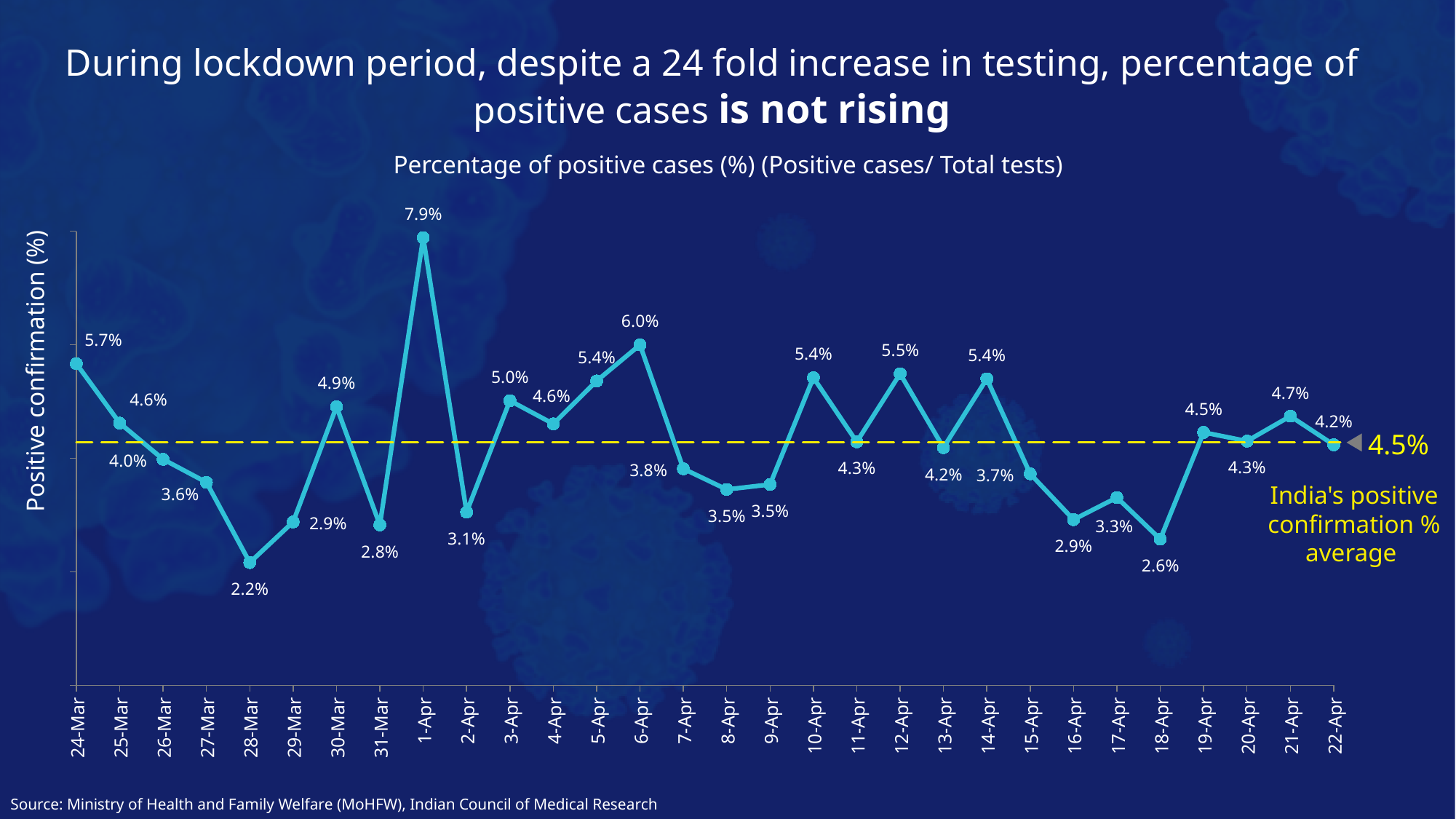
On which date is the percentage of positive cases lowest? 28-Mar What is the percentage of positive cases on 1-Apr? 7.9% What is the difference between the percentage of positive cases on 1-Apr and on 2-Apr? 4.8% What is the percentage of positive cases on 22-Apr? 4.2% What kind of chart is shown on the slide? Line chart What is the difference between the percentage of positive cases on 24-Mar and on 22-Apr? 1.5% What is the percentage of positive cases on 28-Mar? 2.2% What is the label of the y axis? Positive confirmation (%) What value does the yellow dashed line represent? 4.5% How many dates are plotted on the x axis? 30 Which date has a higher percentage of positive cases, 6-Apr or 12-Apr? 6-Apr On which date is the percentage of positive cases highest? 1-Apr